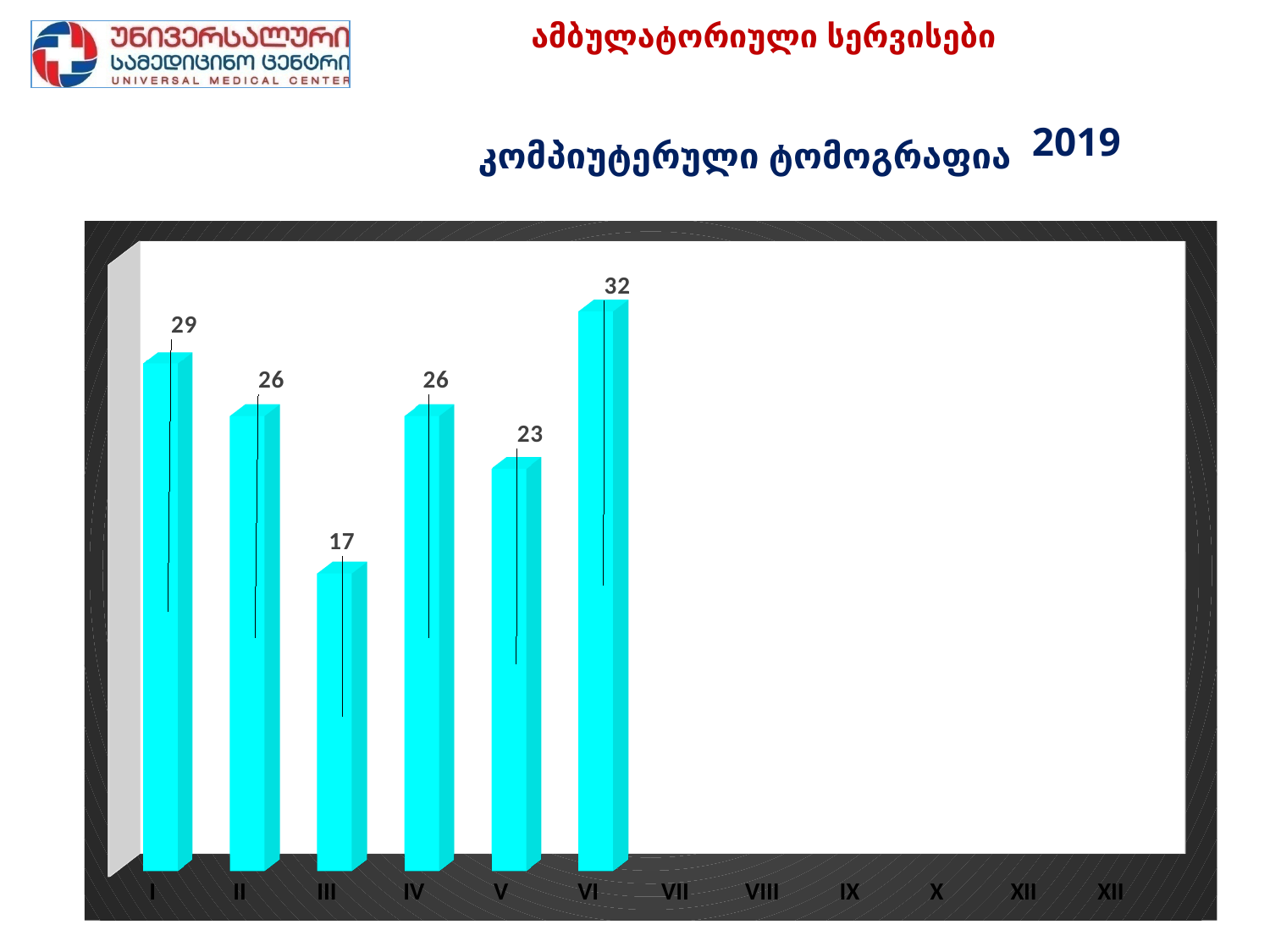
What year is shown in the chart title? 2019 What is the difference between the values for I and V? 6 Which category has the highest value? VI What is the difference between the values for VI and III? 15 Which category has the lowest value? III What is the value for category I? 29 Which is larger, the value for II or the value for V? II How many bars have data labels on the chart? 6 What is the value for category III? 17 What is the value for category VI? 32 What kind of chart is shown on the slide? bar chart What is the value for category V? 23